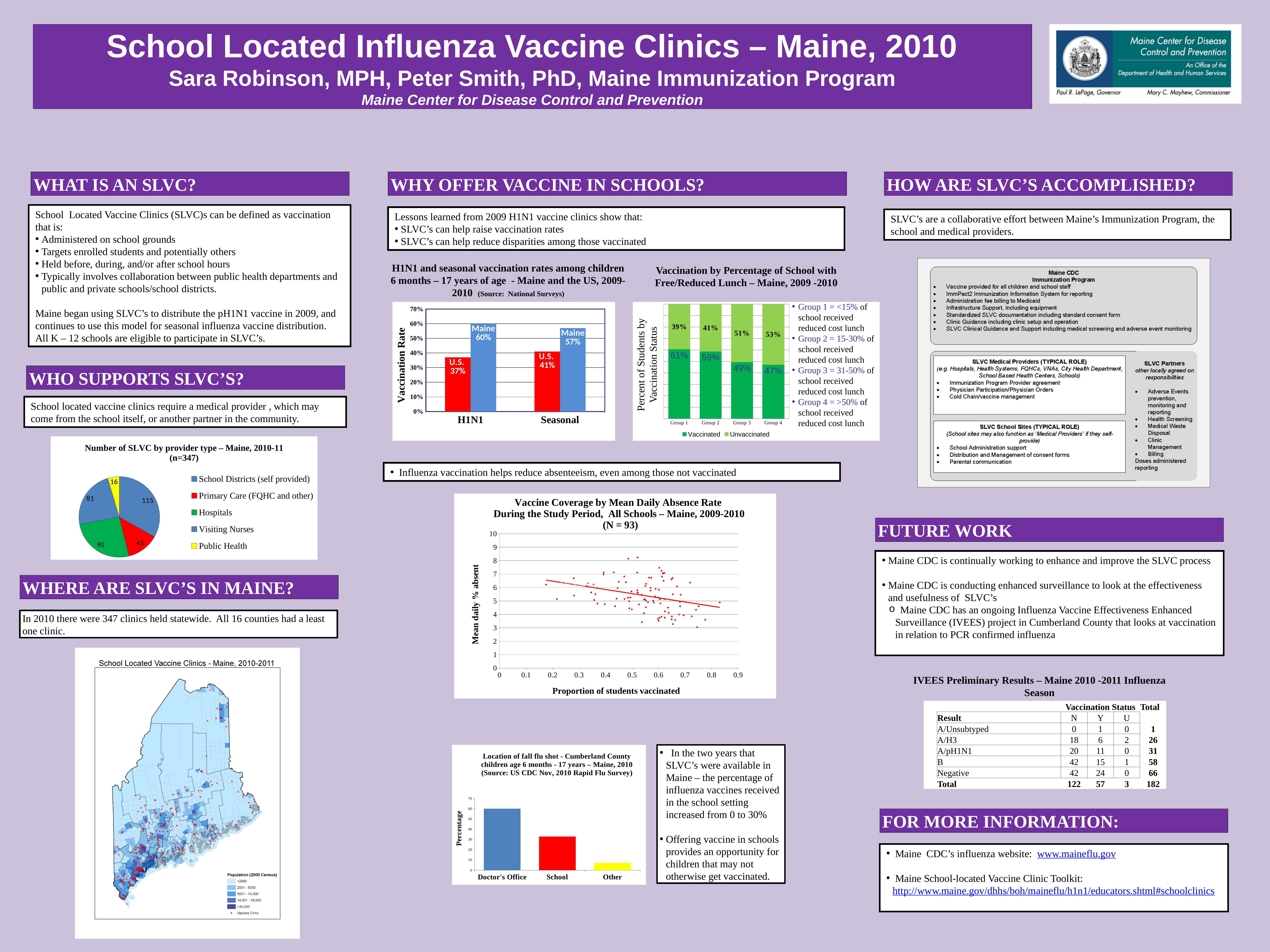
In the 'Location of fall flu shot - Cumberland County' bar chart, is the value for Doctor's Office greater or less than 50? greater In the 'H1N1 and seasonal vaccination rates' bar chart, what is the U.S. vaccination rate for Seasonal? 41% In the 'H1N1 and seasonal vaccination rates' bar chart, what is the Maine vaccination rate for H1N1? 60% In the 'Number of SLVC by provider type' pie chart, which provider type has the smallest slice? Public Health In the 'Number of SLVC by provider type' pie chart, how many provider types are shown in the legend? 5 In the 'Vaccine Coverage by Mean Daily Absence Rate' chart, does the trend line rise or fall as the proportion of students vaccinated increases? fall In the 'Number of SLVC by provider type' pie chart, which provider type has the largest slice? School Districts (self provided) In the 'Vaccination by Percentage of School with Free/Reduced Lunch' chart, which group has the highest vaccinated percentage? Group 1 In the 'Vaccination by Percentage of School with Free/Reduced Lunch' chart, what percentage of students in Group 3 were vaccinated? 49% In the 'Vaccination by Percentage of School with Free/Reduced Lunch' chart, how many series does the legend list? 2 In the 'Number of SLVC by provider type' pie chart, how many clinics were provided by Hospitals? 90 In the 'H1N1 and seasonal vaccination rates' bar chart, what is the difference between the Maine and U.S. H1N1 vaccination rates? 23%